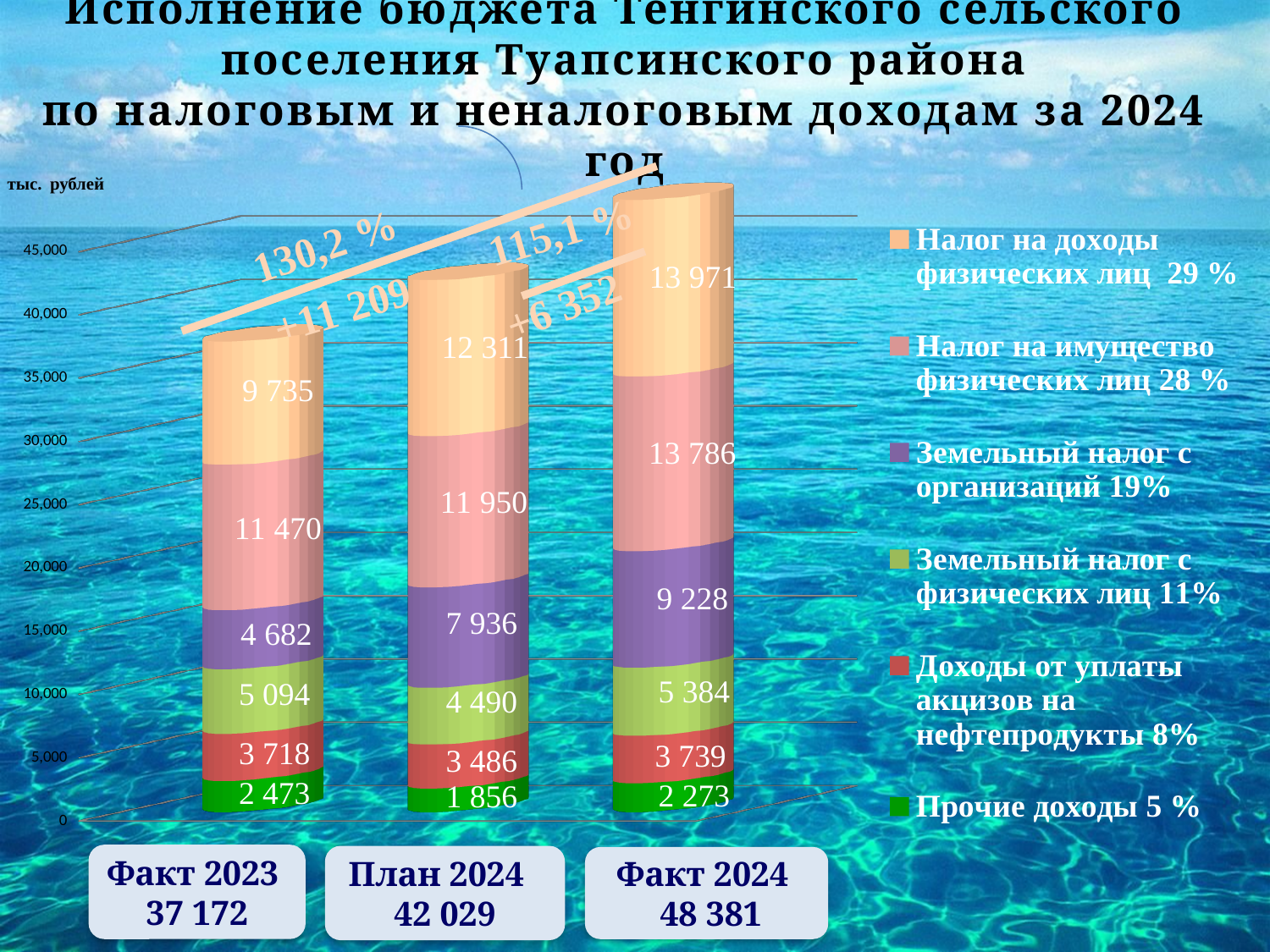
Which is larger: Земельный налог с физических лиц for Факт 2023 or for План 2024? Факт 2023 What is the value of Земельный налог с организаций for План 2024? 7 936 How many series does the legend list? 6 How many bars (categories) are shown in the chart? 3 What is the difference between Налог на имущество физических лиц for Факт 2024 and for Факт 2023? 2 316 What is the total of the stacked bar for Факт 2024? 48 381 What kind of chart is shown on the slide? Stacked bar chart What is the value of Налог на доходы физических лиц for Факт 2024? 13 971 Which series has the smallest value in the План 2024 bar? Прочие доходы What is the value of Прочие доходы for Факт 2023? 2 473 Which bar has the highest total? Факт 2024 What is the difference between Доходы от уплаты акцизов на нефтепродукты for Факт 2024 and for План 2024? 253